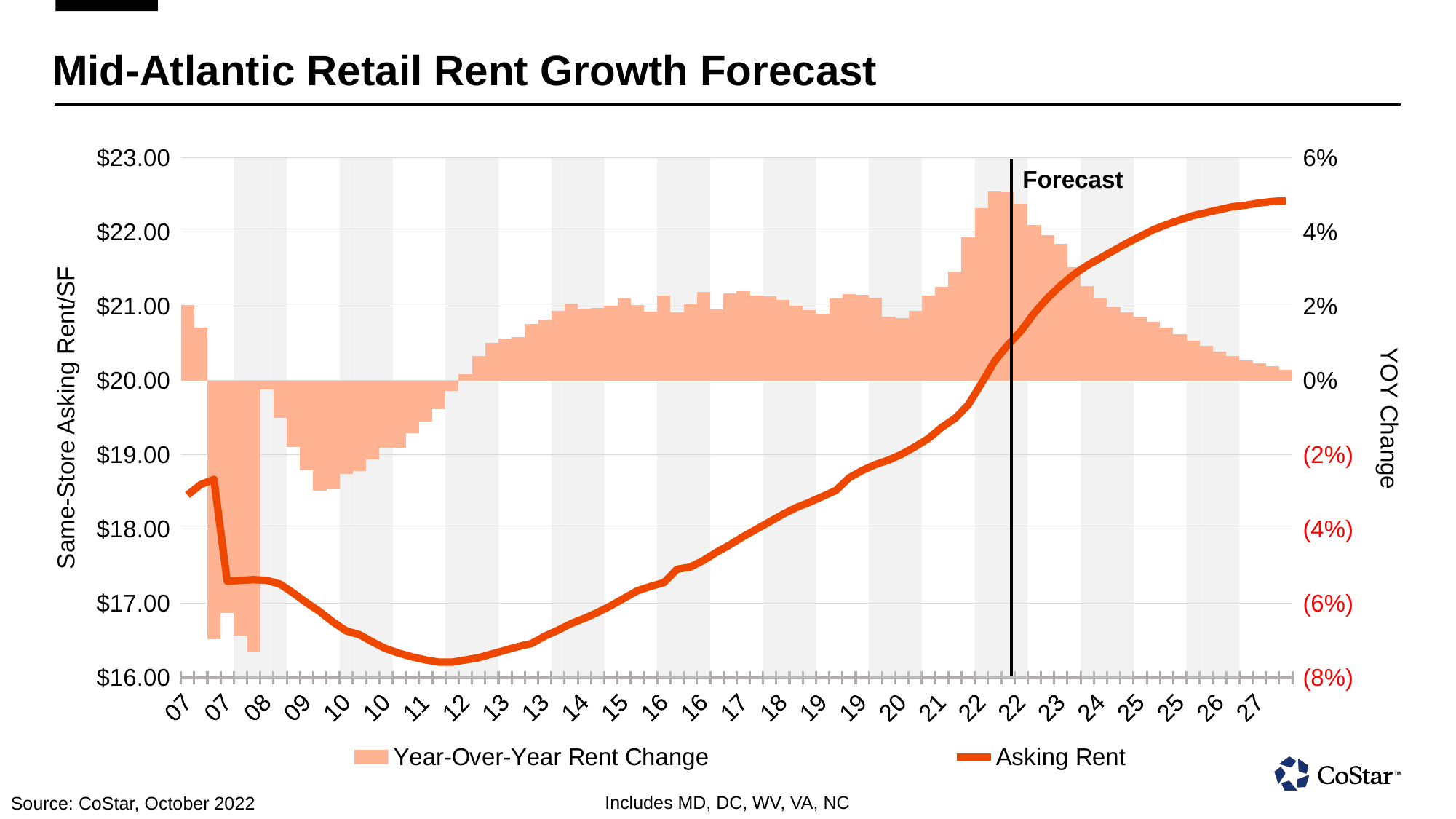
In which year does the Year-Over-Year Rent Change reach its highest value? 2022 Is the peak Year-Over-Year Rent Change value in 2022 greater or less than 4%? greater How many series does the chart's legend list? 2 What is the title of the chart? Mid-Atlantic Retail Rent Growth Forecast Is the Asking Rent value at the start of 2007 greater or less than $18.00? greater Which is larger, the Asking Rent in 2027 or the Asking Rent in 2007? 2027 Do the Year-Over-Year Rent Change bars rise or fall from 2022 to 2027? fall What kind of chart is this? A combination bar and line chart Does the Asking Rent line rise or fall from 2012 to 2027? rise Is the Asking Rent value in 2012 greater or less than $17.00? less What are the two entries in the chart's legend? Year-Over-Year Rent Change and Asking Rent